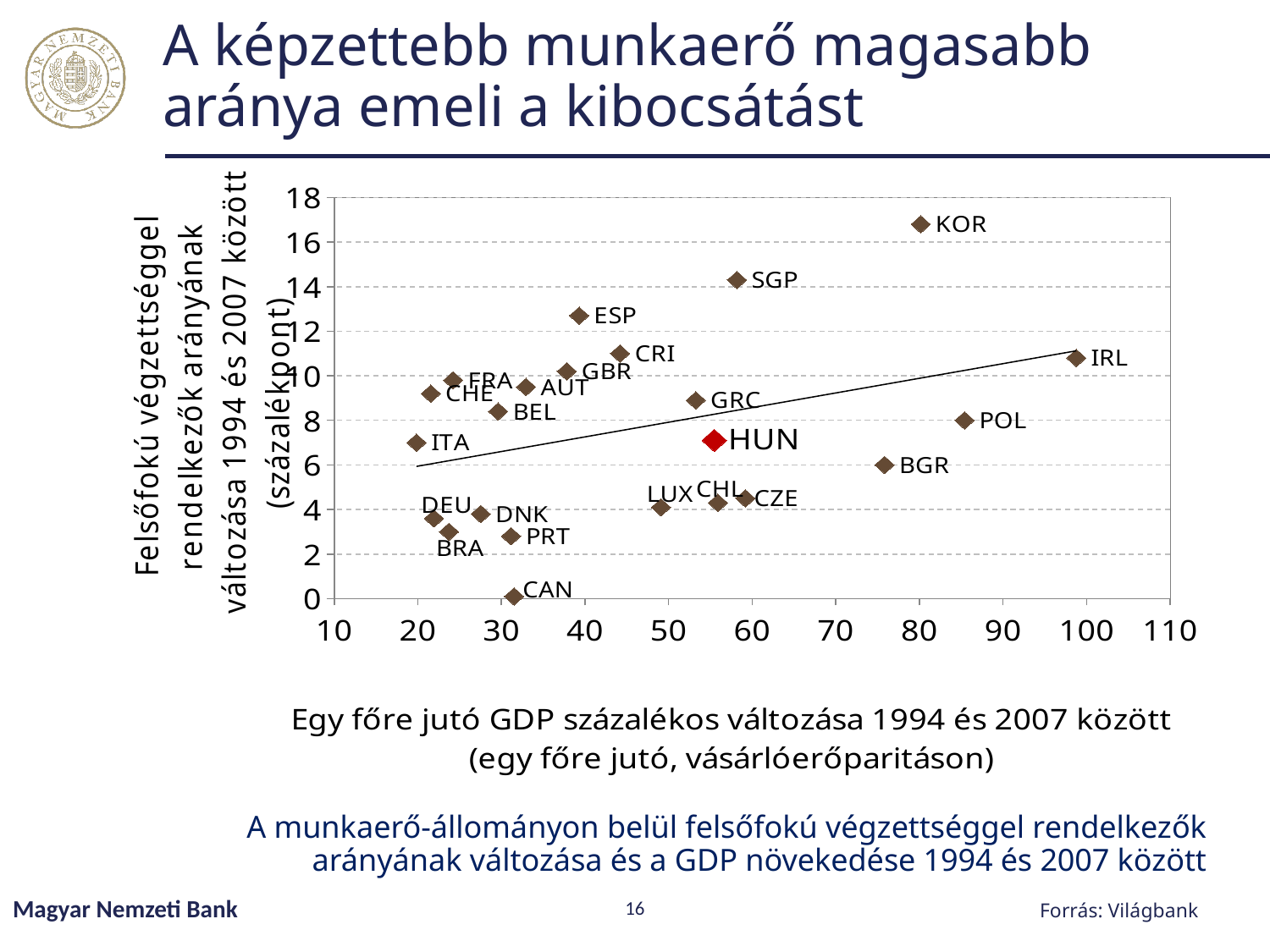
Is the vertical-axis value for CAN greater or less than 2? less Is the horizontal-axis value for HUN greater or less than 50? greater Which country has the highest value on the vertical axis (change in share of tertiary-educated workers)? KOR Is the horizontal-axis value for IRL greater or less than 90? greater Which has the higher vertical-axis value, PRT or CAN? PRT Which country's point is highlighted in red on the chart? HUN How many country points are plotted on the chart? 23 Which has the higher vertical-axis value, ESP or CRI? ESP What kind of chart is shown on the slide? scatter chart Which country has the lowest value on the vertical axis? CAN Which country has the highest value on the horizontal axis (GDP per capita change)? IRL